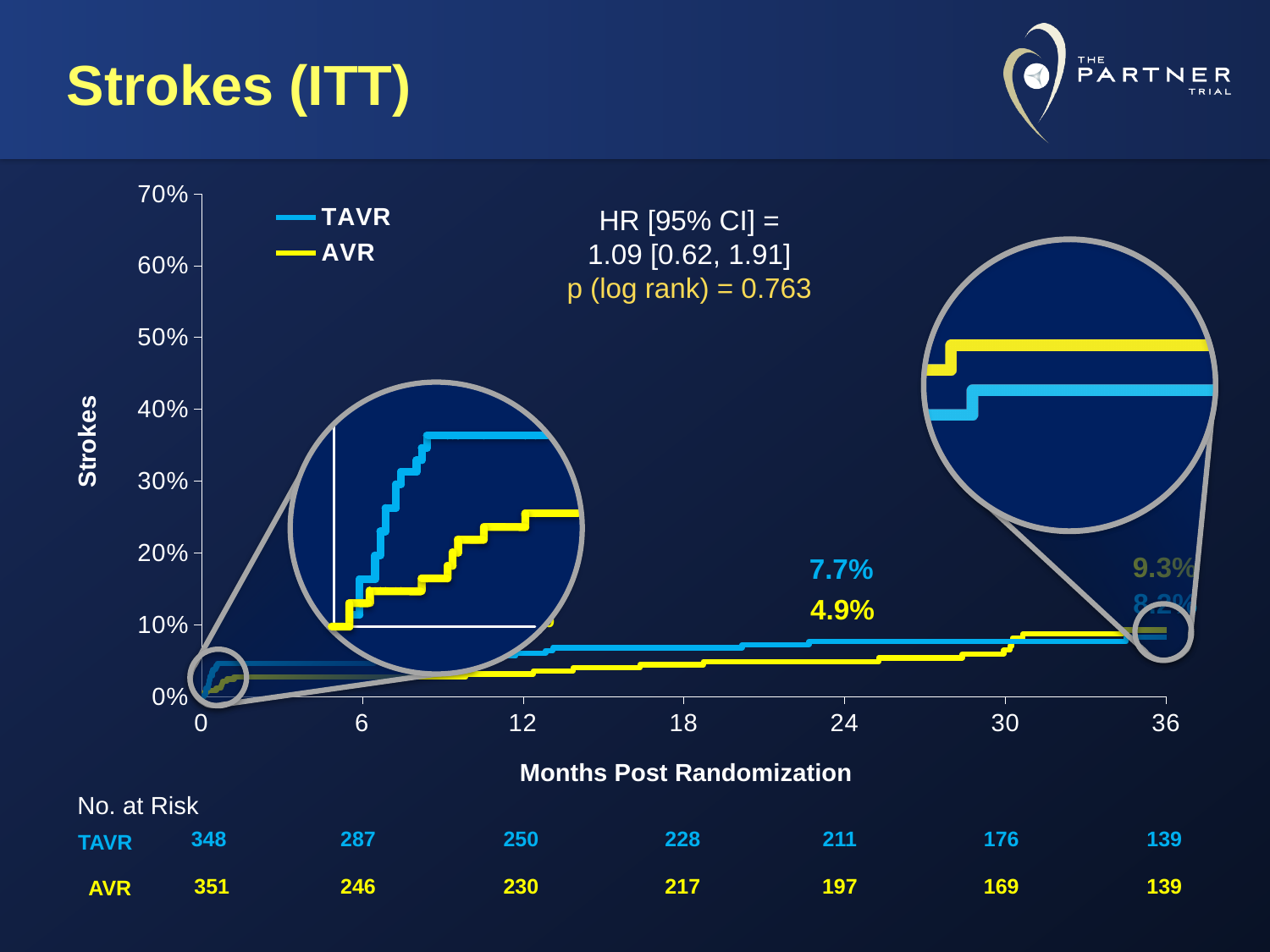
What kind of chart is shown on the slide? line chart At 24 months, which group has the higher stroke rate, TAVR or AVR? TAVR How many series does the legend list? 2 What is the log rank p value shown on the chart? 0.763 What is the difference between the TAVR and AVR stroke rates at 24 months? 2.8 percentage points Do the stroke curves rise or fall as months post randomization increase? rise Is the TAVR stroke rate at 24 months greater or less than 10%? less What is the stroke rate for AVR at 24 months? 4.9% How many TAVR patients are at risk at month 0? 348 What is the stroke rate for TAVR at 24 months? 7.7% How many AVR patients are at risk at month 36? 139 What is the hazard ratio with 95% CI shown on the chart? 1.09 [0.62, 1.91]